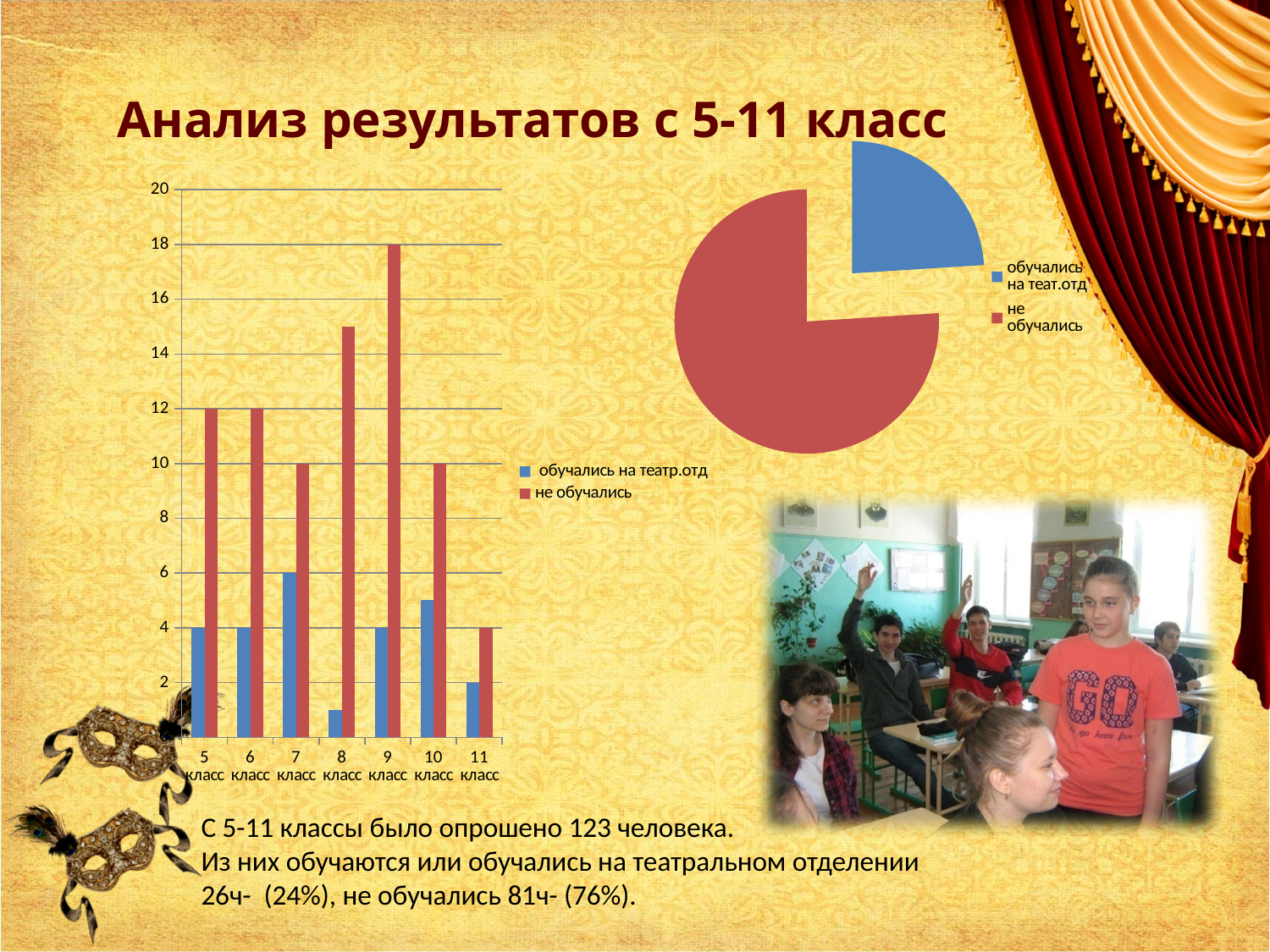
On the bar chart, which class has the highest value for 'не обучались'? 9 класс On the bar chart, what is the value of 'не обучались' for 11 класс? 4 On the bar chart, what is the value of 'не обучались' for 5 класс? 12 On the bar chart, what is the value of 'обучались на театр.отд' for 7 класс? 6 On the bar chart, what is the value of 'не обучались' for 9 класс? 18 On the bar chart, what is the difference between 'не обучались' for 9 класс and 'не обучались' for 5 класс? 6 How many series does the legend of the bar chart list? 2 On the pie chart, which slice is larger: 'обучались на теат.отд' or 'не обучались'? не обучались On the bar chart, how many classes are shown on the x axis? 7 On the bar chart, is the value of 'не обучались' for 8 класс greater or less than 14? greater On the bar chart, is the value of 'обучались на театр.отд' for 8 класс greater or less than 2? less On the bar chart, which class has the lowest value for 'обучались на театр.отд'? 8 класс